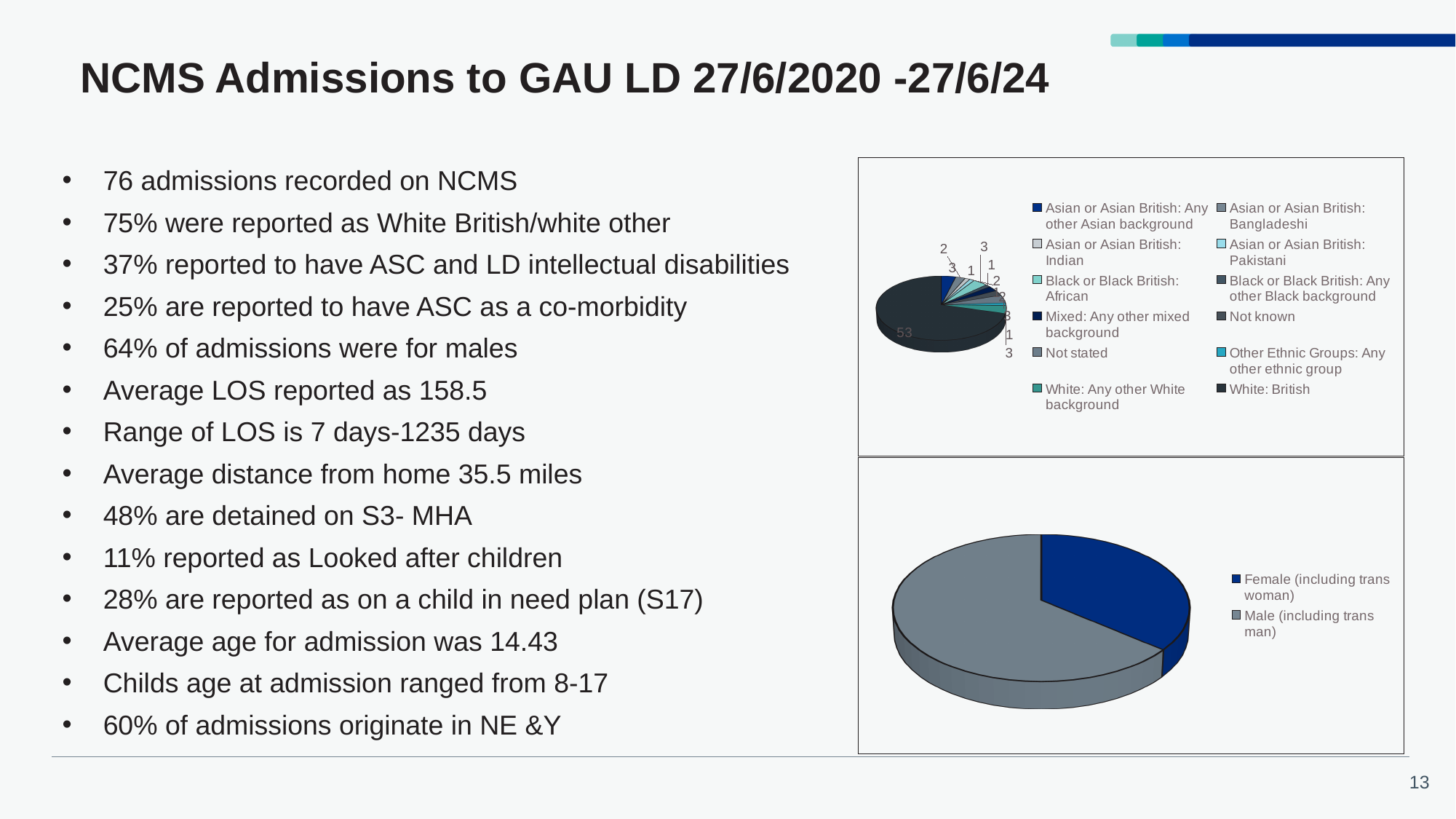
What kind of chart is the bottom chart on the right of the slide? pie chart In the top pie chart (ethnicity), what value is labelled on the largest slice? 53 In the top pie chart (ethnicity), which category has the largest slice? White: British In the bottom pie chart (gender), is the slice for Female (including trans woman) larger or smaller than the slice for Male (including trans man)? smaller In the bottom pie chart (gender), which category has the smaller slice? Female (including trans woman) In the bottom pie chart (gender), what colour is the Female (including trans woman) slice? dark blue How many entries does the legend of the top pie chart (ethnicity) list? 12 How many entries does the legend of the bottom pie chart (gender) list? 2 What kind of chart is the top chart on the right of the slide? pie chart In the bottom pie chart (gender), which category has the larger slice? Male (including trans man) In the top pie chart (ethnicity), is the value for White: British greater or less than 50? greater In the bottom pie chart (gender), what colour is the Male (including trans man) slice? grey